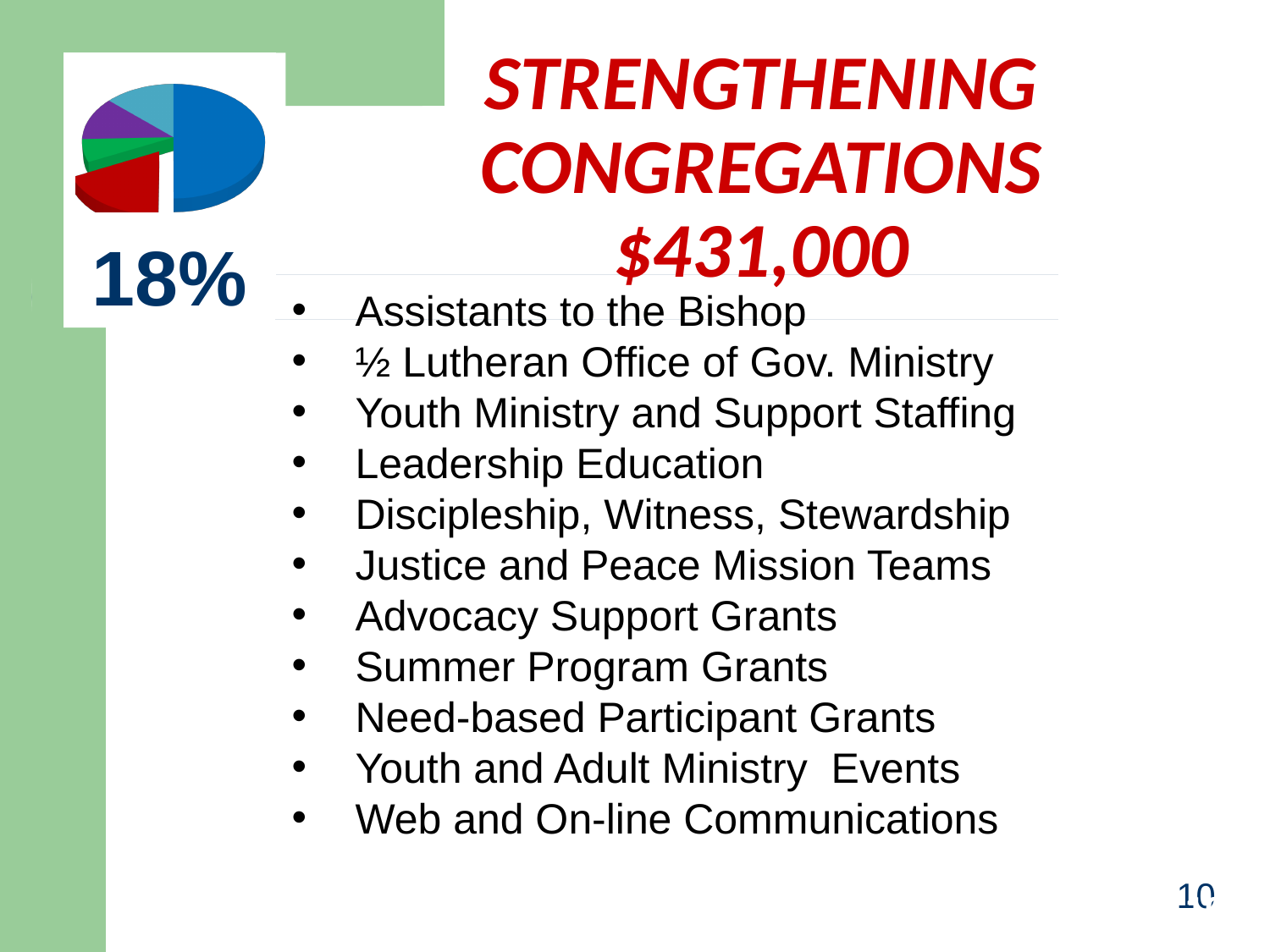
How many slices does the pie chart have? 5 Which colour slice is the largest in the pie chart? blue Is the blue slice or the red slice larger in the pie chart? blue Is the red slice or the green slice larger in the pie chart? red Does the pie chart have a legend? No Which colour slice is pulled out (exploded) from the pie chart? red What kind of chart is shown on the slide? pie chart What percentage is printed next to the pie chart? 18%